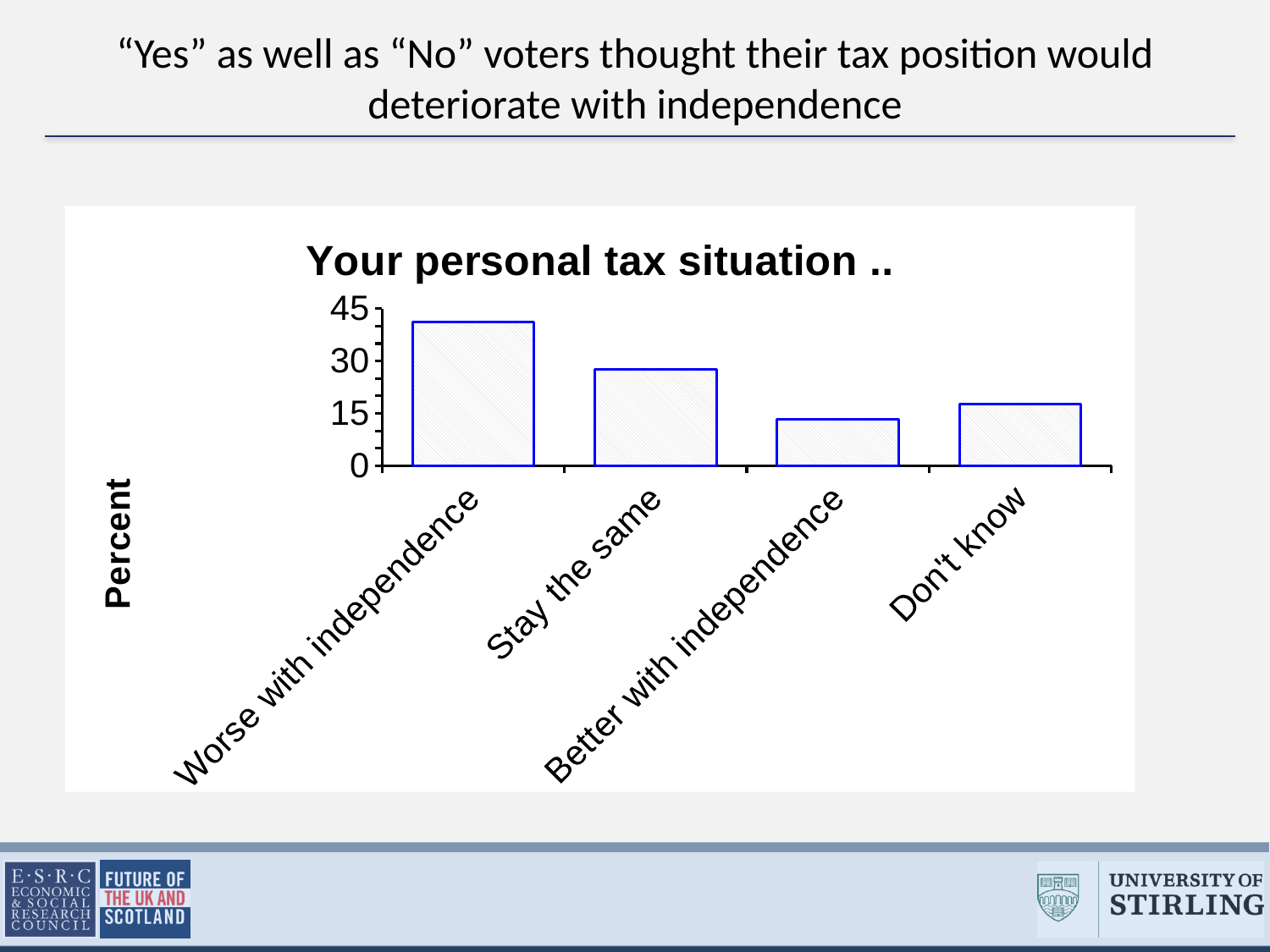
What is the label on the vertical axis of the chart? Percent Is the value for "Don't know" greater or less than 15? greater How many categories are shown on the x axis of the chart? 4 What kind of chart is shown on the slide? bar chart Is the value for "Don't know" greater or less than 30? less Which category has the lowest bar in the chart? Better with independence Is the value for "Worse with independence" greater or less than 30? greater Which is larger, the value for "Stay the same" or the value for "Don't know"? Stay the same What is the title of the chart? Your personal tax situation .. Which category has the highest bar in the chart? Worse with independence